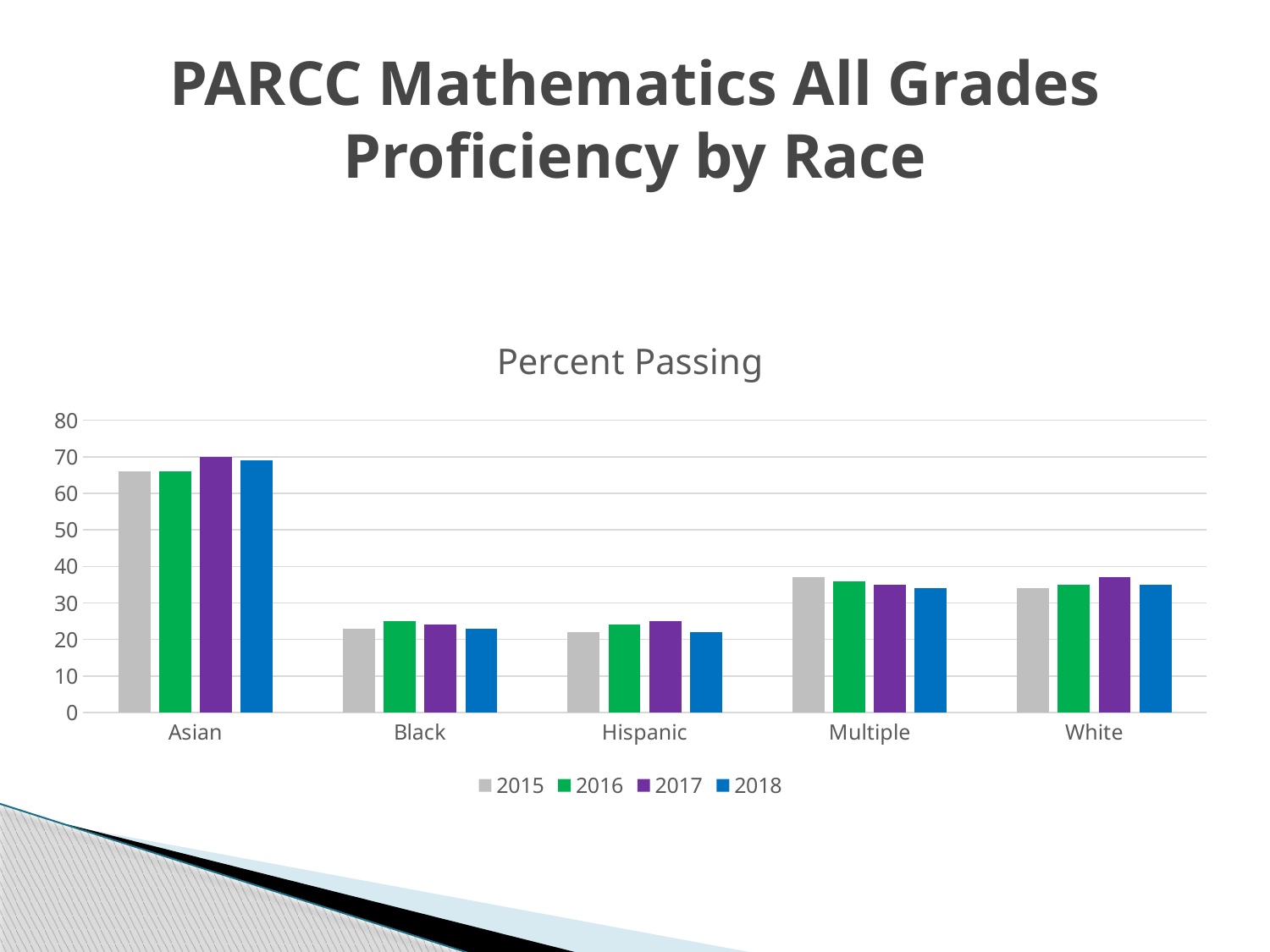
Is the 2018 value for Hispanic greater or less than 30? less How many series does the chart's legend list? 4 How many race categories are shown on the x axis of the chart? 5 Which is larger, the 2018 value for Asian or the 2018 value for Black? Asian Do the values for Multiple rise or fall from 2015 to 2018? Fall What is the title of the chart? Percent Passing What kind of chart is shown on the slide? Bar chart Is the 2015 value for Black greater or less than 30? less Is the 2015 value for Multiple greater or less than 30? greater Which race category has the highest 2018 value? Asian Which colour represents the 2018 series in the legend? Blue